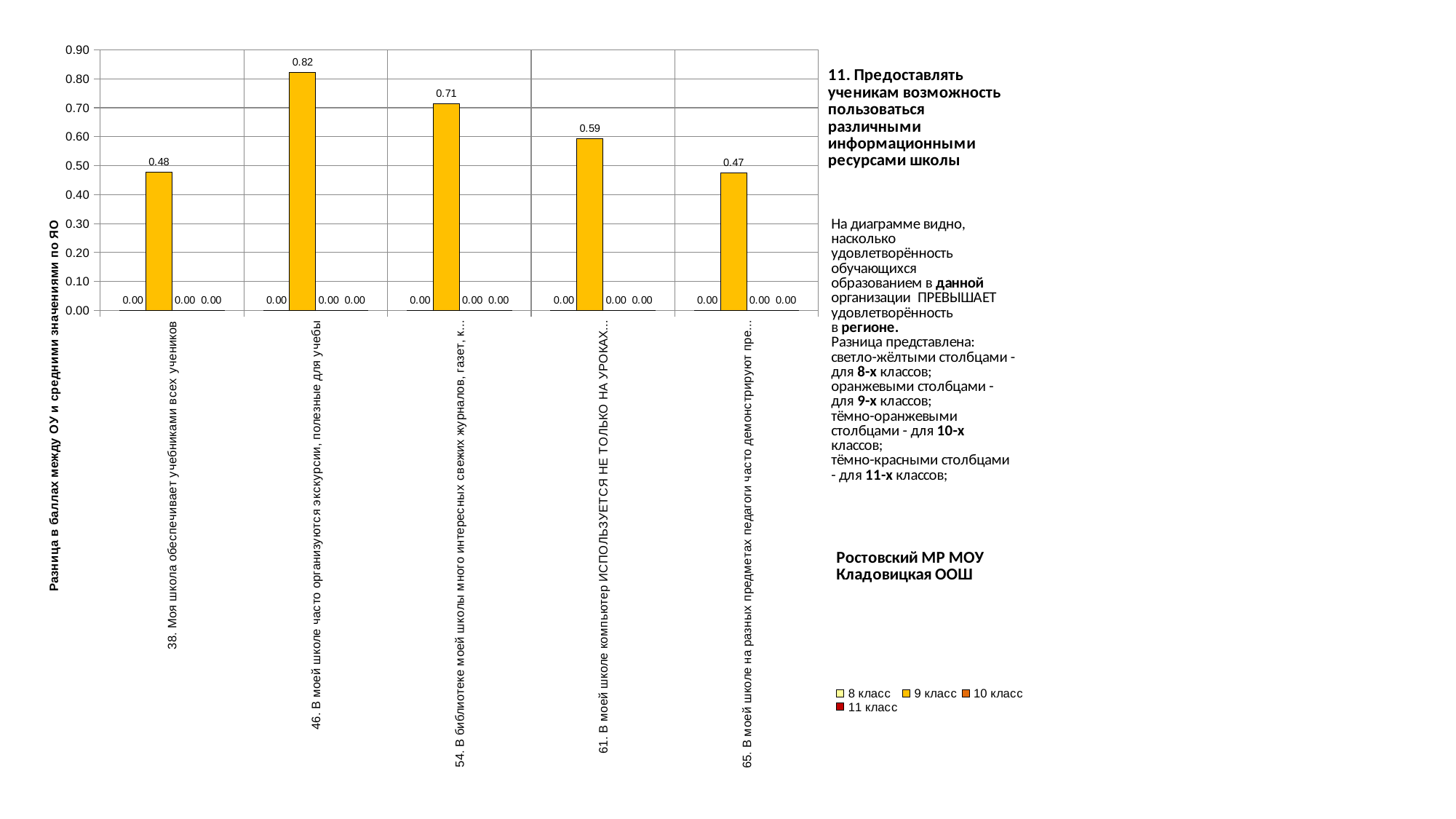
What is the value for 9 класс for category 61 (В моей школе компьютер ИСПОЛЬЗУЕТСЯ НЕ ТОЛЬКО НА УРОКАХ...)? 0.59 Which is larger for 9 класс: the value for category 54 or the value for category 61? Category 54 What is the value for 8 класс for category 54 (В библиотеке моей школы много интересных свежих журналов...)? 0.00 Which category has the highest value for 9 класс? 46. В моей школе часто организуются экскурсии, полезные для учебы What is the difference between the 9 класс values for category 46 and category 38? 0.34 How many series does the legend list? 4 How many categories are shown on the x axis? 5 What kind of chart is shown on the slide? Bar chart Is the 9 класс value for category 54 greater or less than 0.60? greater Which category has the lowest value for 9 класс? 65. В моей школе на разных предметах педагоги часто демонстрируют пре... What is the value for 9 класс for category 38 (Моя школа обеспечивает учебниками всех учеников)? 0.48 What is the value for 9 класс for category 46 (В моей школе часто организуются экскурсии, полезные для учебы)? 0.82